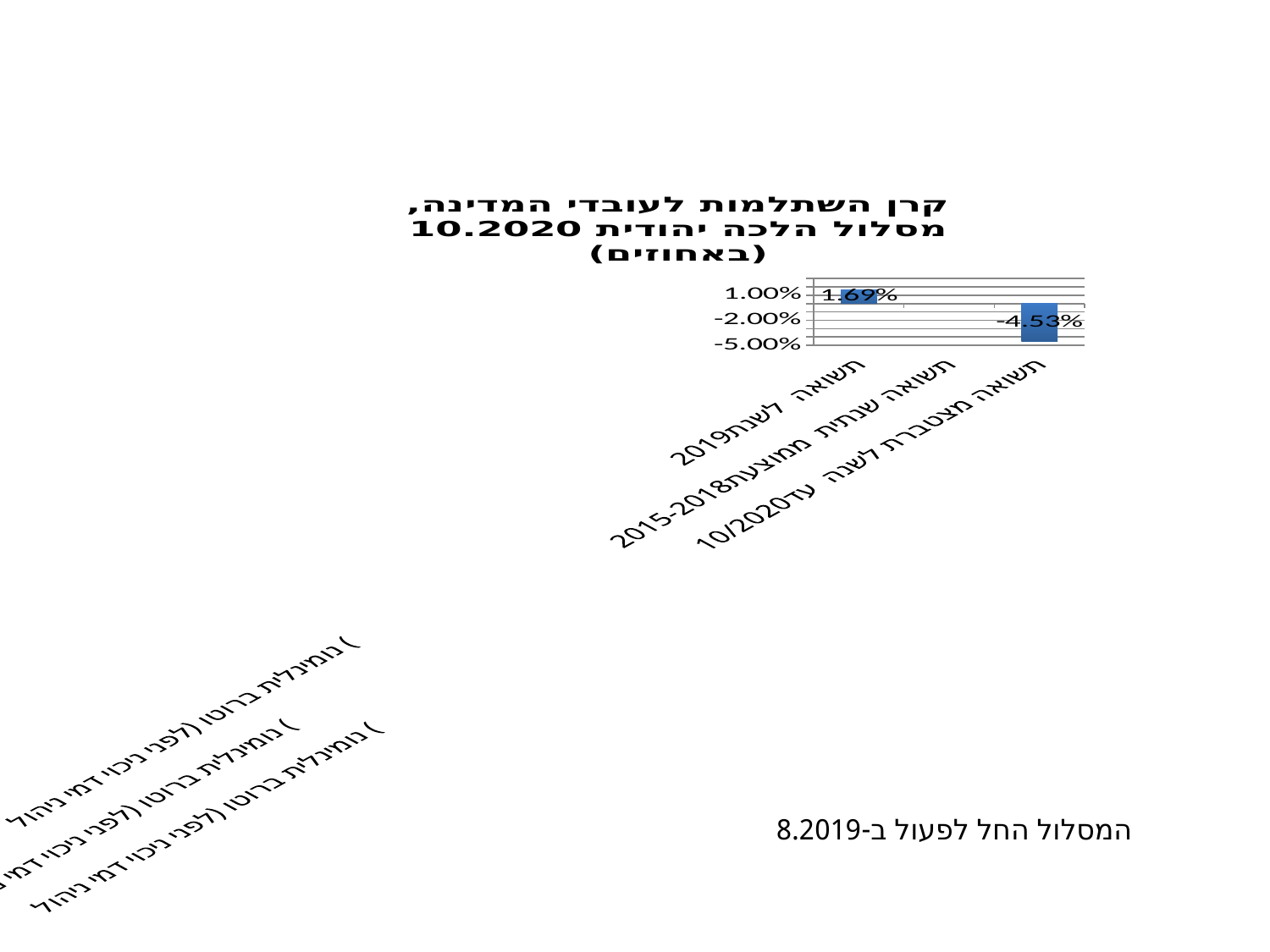
Which category has the lowest value? תשואה מצטברת לשנה עד 10/2020 What colour are the bars in the chart? blue How many categories are shown on the x axis of the chart? 3 What is the difference between the value for תשואה לשנת 2019 and the value for תשואה מצטברת לשנה עד 10/2020? 6.22% What is the value for תשואה לשנת 2019? 1.69% Is the value for תשואה לשנת 2019 greater or less than 1.00%? greater Which category has the highest value? תשואה לשנת 2019 What is the title of the chart? קרן השתלמות לעובדי המדינה, מסלול הלכה יהודית 10.2020 (באחוזים) Which is larger: the value for תשואה לשנת 2019 or the value for תשואה מצטברת לשנה עד 10/2020? תשואה לשנת 2019 Is the value for תשואה מצטברת לשנה עד 10/2020 greater or less than -2.00%? less What kind of chart is shown on the slide? bar chart What is the value for תשואה מצטברת לשנה עד 10/2020? -4.53%